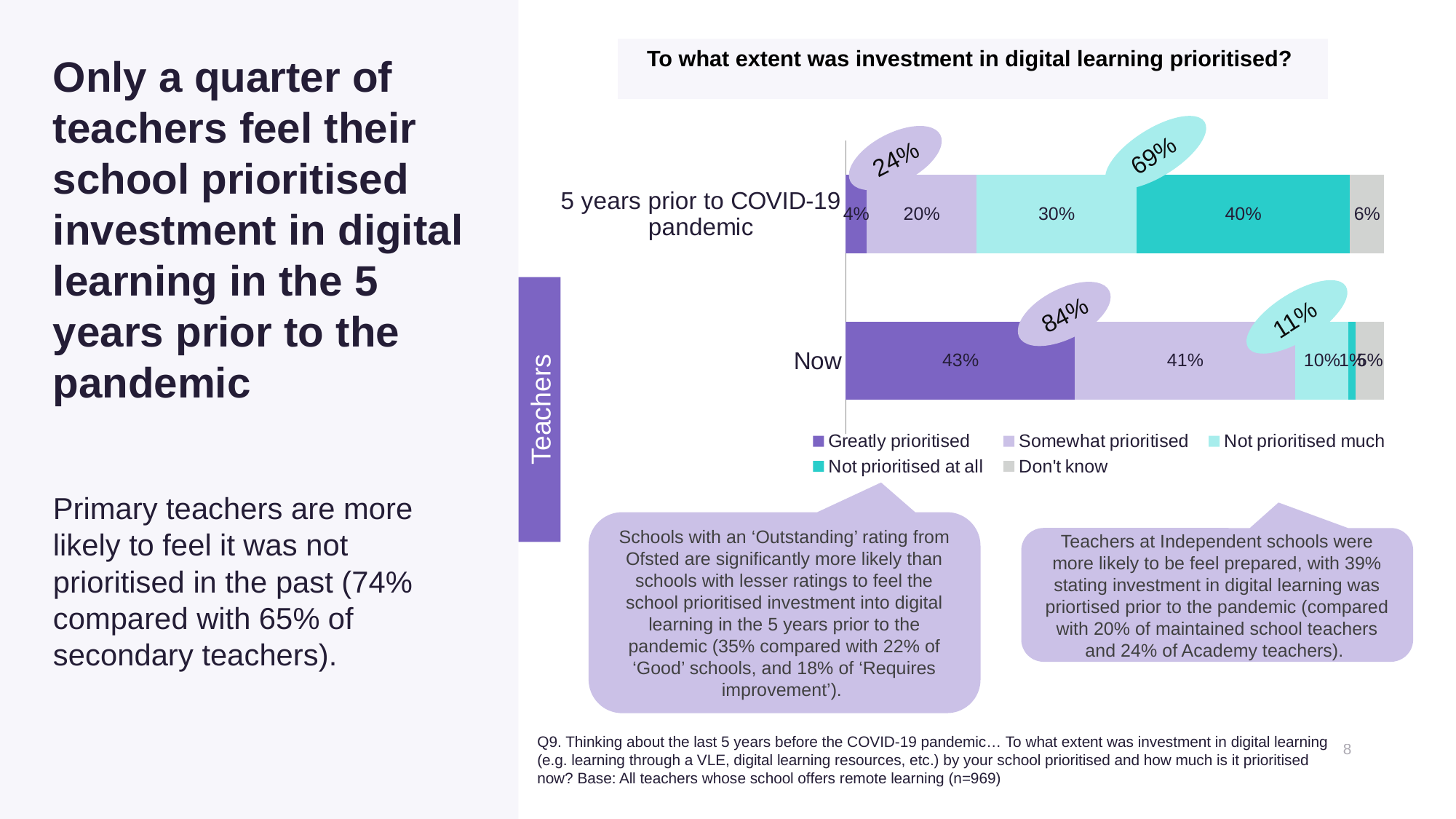
Which is larger: 'Not prioritised much' for '5 years prior to COVID-19 pandemic' or 'Not prioritised much' for 'Now'? 5 years prior to COVID-19 pandemic Which segment is the smallest in the 'Now' bar? Not prioritised at all What is the value for 'Not prioritised at all' in the '5 years prior to COVID-19 pandemic' bar? 40% How many series does the legend list? 5 How many categories (bars) are shown in the chart? 2 Which segment is the largest in the '5 years prior to COVID-19 pandemic' bar? Not prioritised at all What is the title of the chart? To what extent was investment in digital learning prioritised? What is the value for 'Don't know' in the 'Now' bar? 5% What is the difference between the 'Greatly prioritised' values for 'Now' and '5 years prior to COVID-19 pandemic'? 39 percentage points What is the value for 'Somewhat prioritised' in the '5 years prior to COVID-19 pandemic' bar? 20% What is the value for 'Greatly prioritised' in the 'Now' bar? 43% What type of chart is shown on the slide? Stacked bar chart